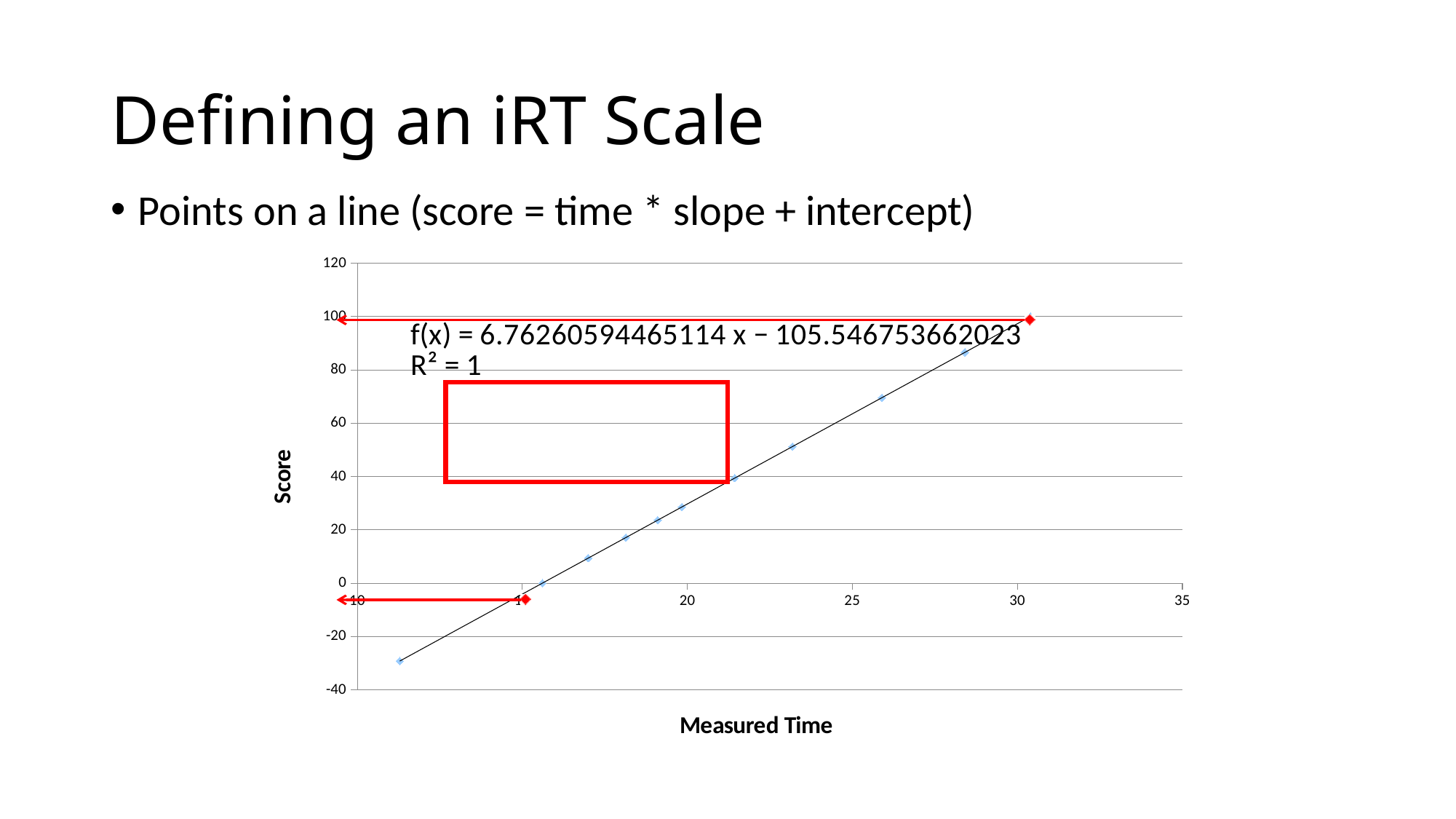
Is the score of the blue data point near Measured Time 26 greater or less than 60? greater What is the slope of the fitted line f(x) printed on the chart? 6.76260594465114 What R² value is printed on the chart for the fitted line? R² = 1 Do the plotted scores rise or fall as Measured Time increases? rise What is the title of the y axis of the chart? Score Is the score of the lowest blue data point (near Measured Time 11) greater or less than -20? less What is the intercept of the fitted line f(x) printed on the chart? −105.546753662023 What is the title of the x axis of the chart? Measured Time What is the highest tick value shown on the x axis? 35 What is the highest tick value shown on the y axis? 120 Is the score of the highest blue data point (near Measured Time 28) greater or less than 80? greater What kind of chart is shown on the slide? scatter chart